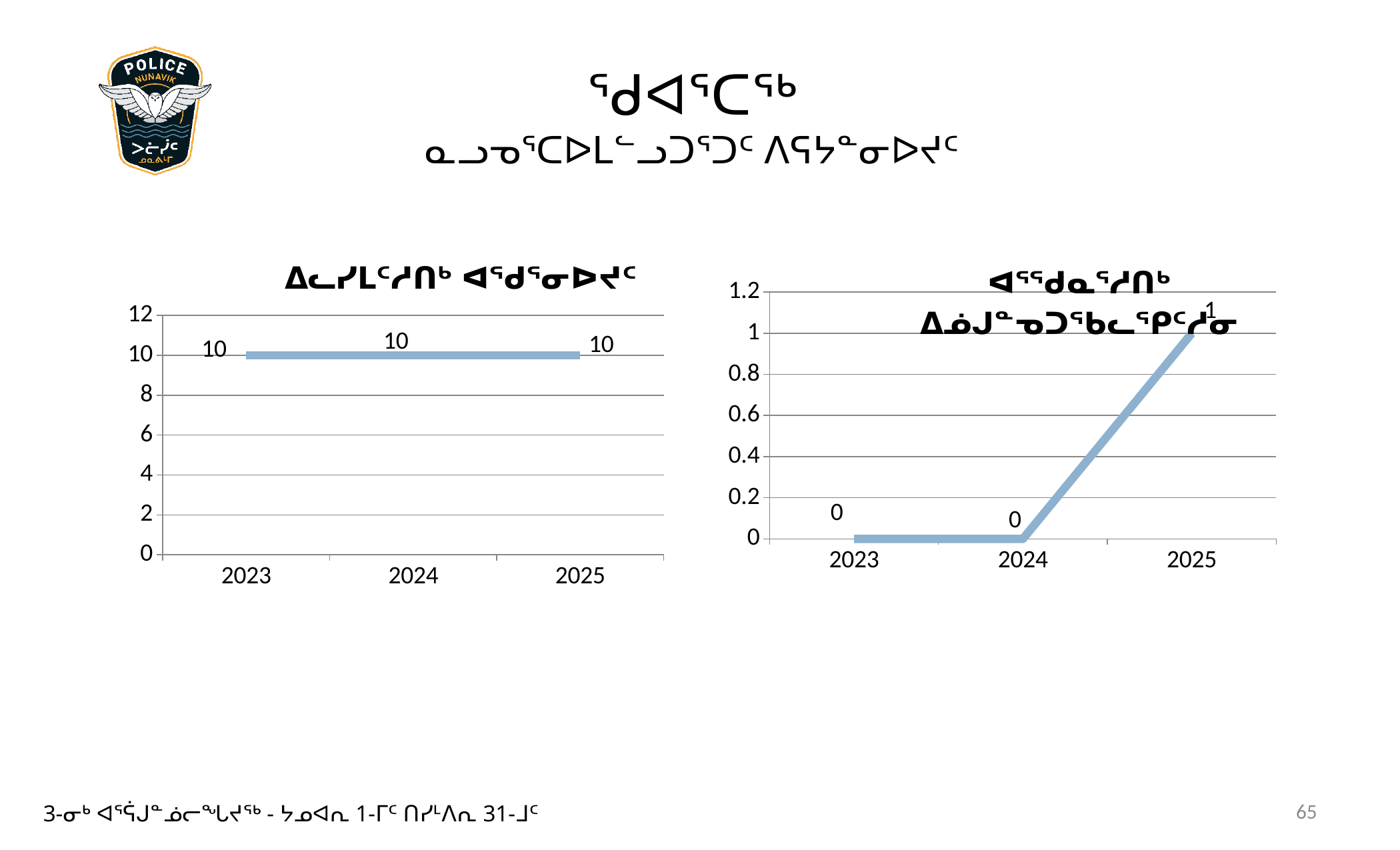
In the left chart, what is the value for 2023? 10 In the left chart, do the values rise, fall or stay flat from 2023 to 2025? Stay flat In the right chart, is the value for 2025 larger than the value for 2024? Yes In the left chart, what is the value for 2025? 10 In the right chart, what is the difference between the values for 2025 and 2023? 1 In the right chart, what is the value for 2025? 1 In the right chart, do the values rise or fall from 2024 to 2025? Rise In the right chart, what is the value for 2024? 0 How many years are shown on the x axis of the left chart? 3 What kind of chart is the right chart? Line chart In the right chart, which year has the highest value? 2025 In the left chart, is the value for 2024 greater or less than 8? greater